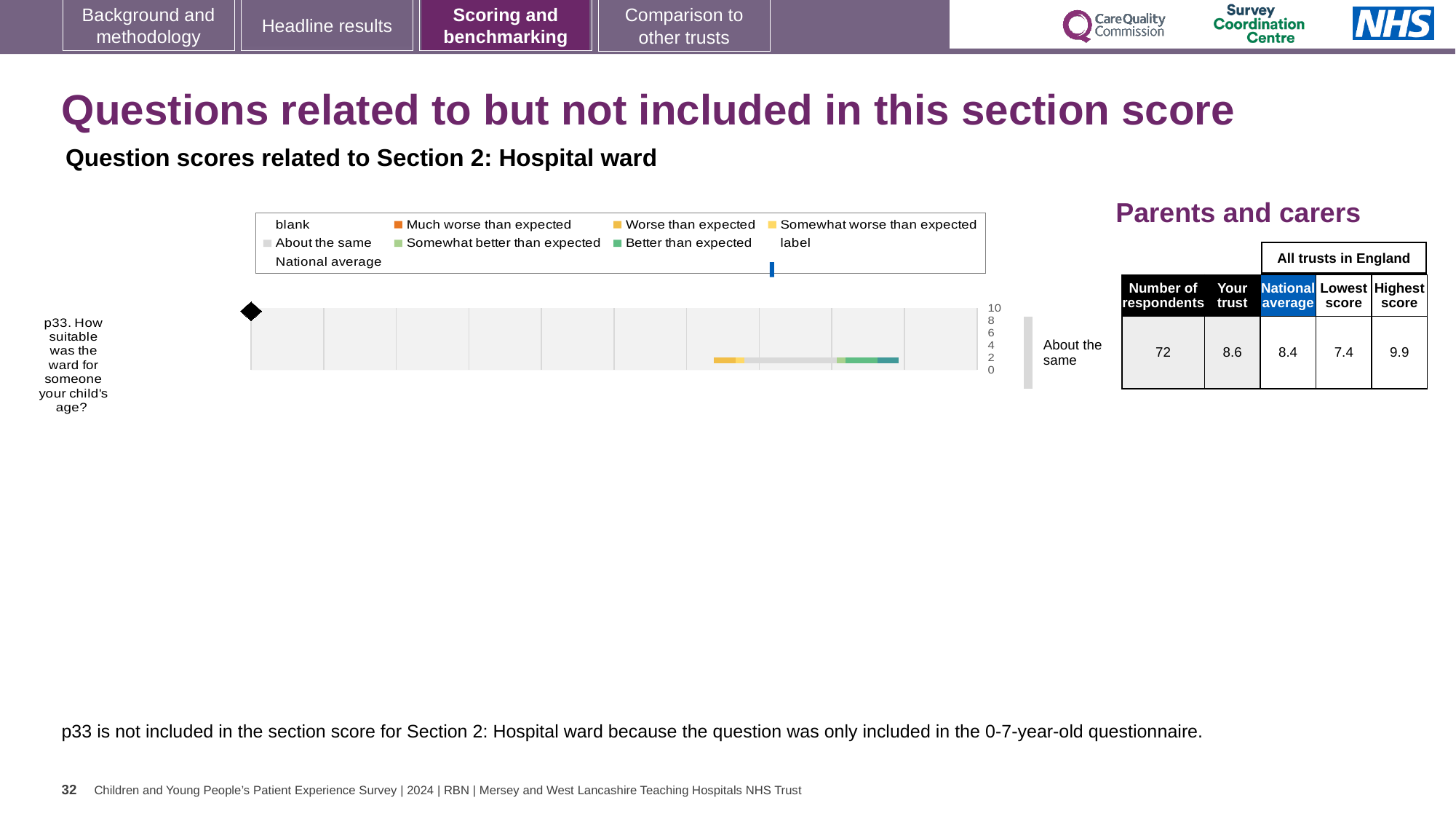
What is the difference between the 'Your trust' score and the national average for p33? 0.2 In the Parents and carers table, what is the 'Your trust' score for p33? 8.6 What kind of chart is used to show the p33 question score? bar chart What colour does the legend use for 'Much worse than expected'? orange How many questions (categories) are plotted in the chart? 1 In the Parents and carers table, what is the lowest score among all trusts in England for p33? 7.4 Which rating label is shown next to the bar for p33? About the same In the Parents and carers table, what is the highest score among all trusts in England for p33? 9.9 What is the difference between the highest score and the lowest score for p33 in the table? 2.5 Which is larger for p33, the 'Your trust' score or the national average? Your trust In the Parents and carers table, what is the number of respondents for p33? 72 In the Parents and carers table, what is the national average score for p33? 8.4